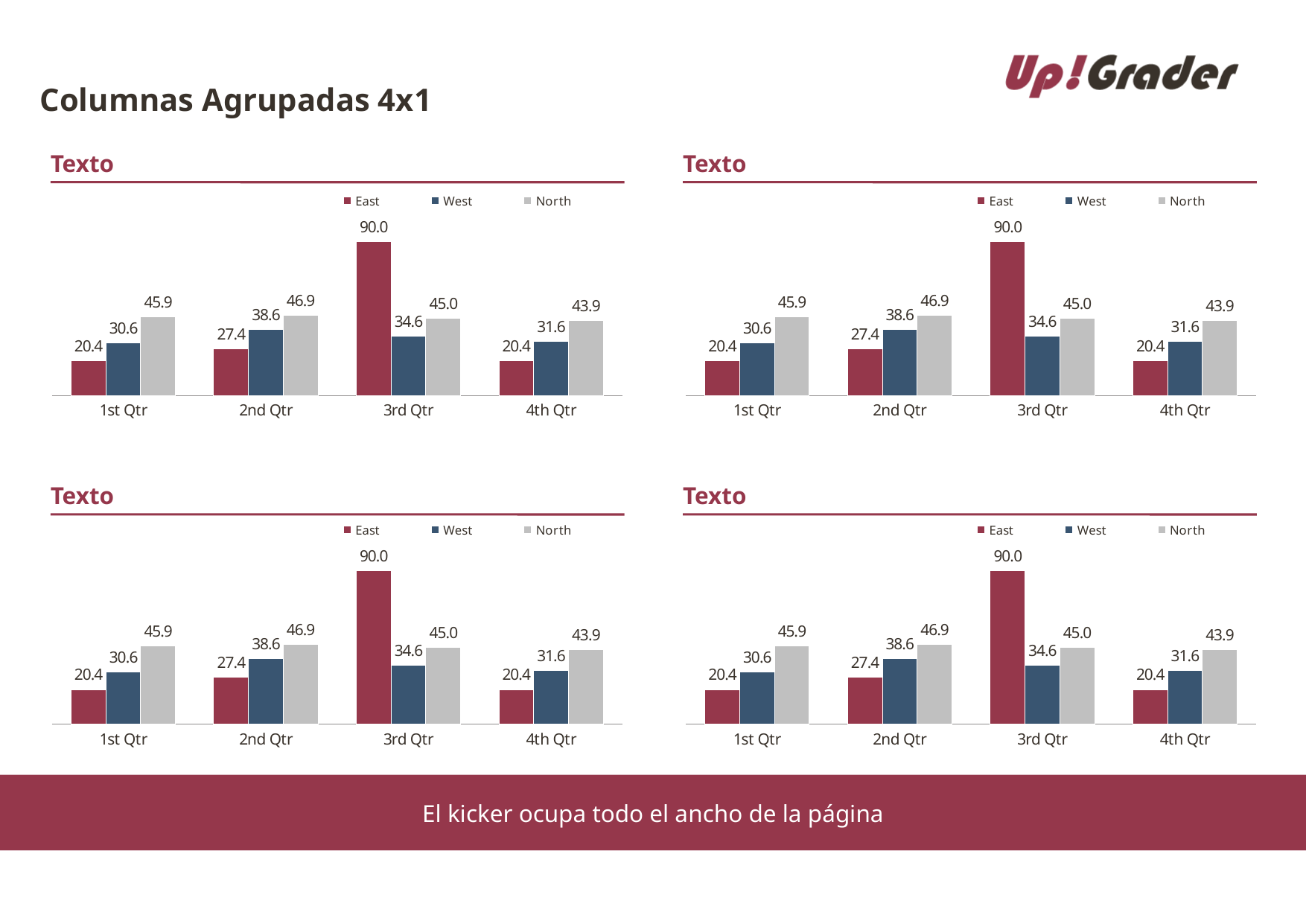
In the bottom-left chart, what is the value for West in 4th Qtr? 31.6 In the bottom-left chart, what is the total of the three series in 2nd Qtr? 112.9 How many series does the legend of the top-left chart list? 3 In the top-left chart, what is the value for East in 3rd Qtr? 90.0 In the bottom-left chart, which is larger in 1st Qtr: West or North? North How many charts are on the slide? 4 In the top-right chart, what is the value for North in 2nd Qtr? 46.9 What kind of chart is the top-right chart? Bar chart In the top-right chart, what is the difference between the East and West values in 3rd Qtr? 55.4 In the top-left chart, which quarter has the lowest value for North? 4th Qtr How many quarters are shown on the x axis of the bottom-right chart? 4 In the bottom-right chart, which quarter has the highest value for East? 3rd Qtr